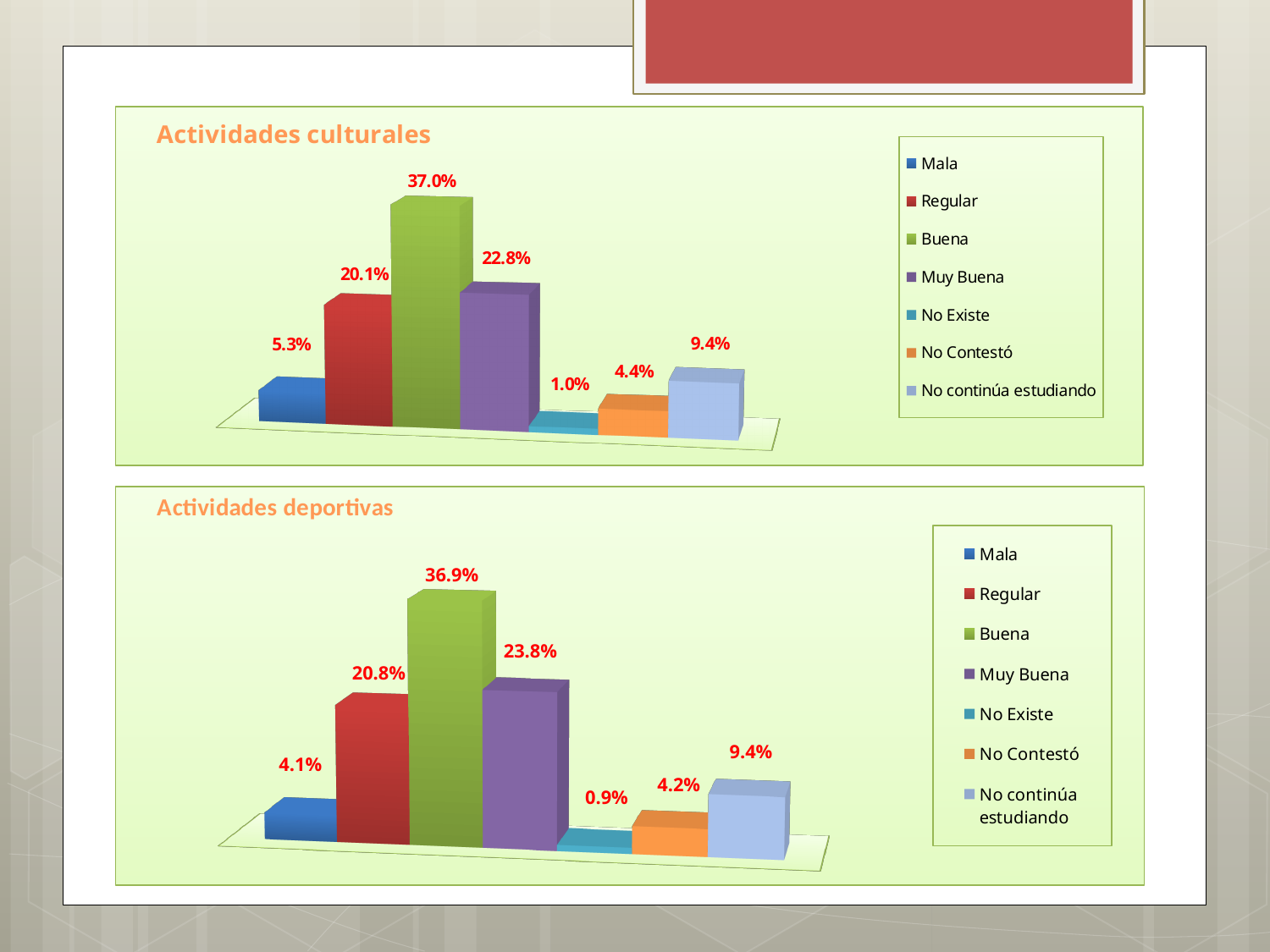
In the 'Actividades culturales' chart, what is the value for No continúa estudiando? 9.4% How many categories does the legend of the 'Actividades deportivas' chart list? 7 In the 'Actividades deportivas' chart, which category has the lowest value? No Existe In the 'Actividades culturales' chart, which category has the highest value? Buena In the 'Actividades deportivas' chart, what is the value for Regular? 20.8% In the 'Actividades culturales' chart, what is the value for Buena? 37.0% In the 'Actividades deportivas' chart, which is larger, No Contestó or Mala? No Contestó In the 'Actividades culturales' chart, which is larger, Muy Buena or Regular? Muy Buena In the 'Actividades culturales' chart, what colour is the bar for Buena? Green What kind of chart is the 'Actividades culturales' chart? Bar chart In the 'Actividades deportivas' chart, what is the difference between Buena and Muy Buena? 13.1% In the 'Actividades culturales' chart, what is the difference between Regular and Mala? 14.8%